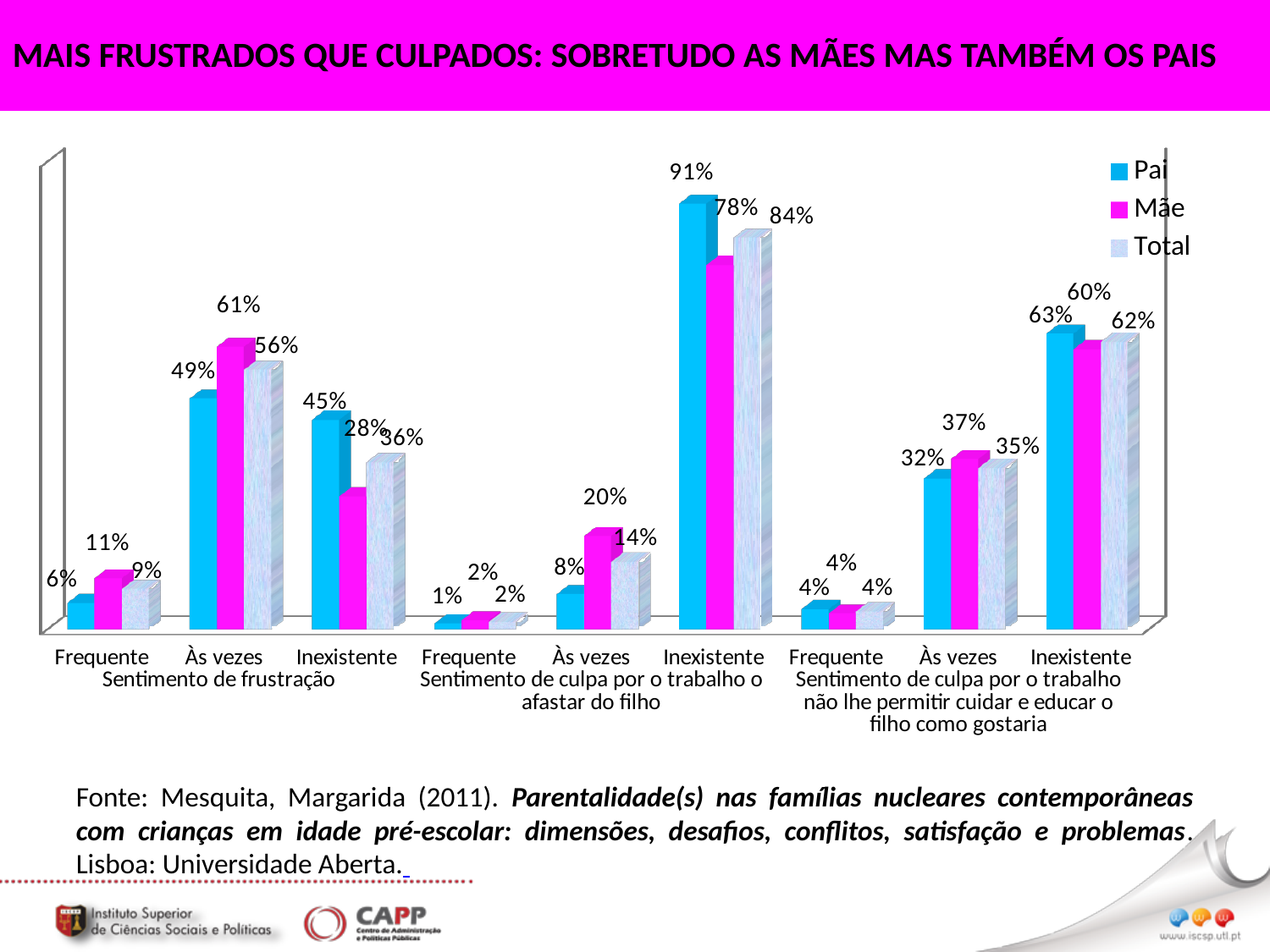
Which category has the lowest value for the Pai series? Frequente (Sentimento de culpa por o trabalho o afastar do filho) What is the difference between the Mãe and Total values for 'Inexistente' under 'Sentimento de culpa por o trabalho o afastar do filho'? 6% What is the value for Pai for 'Inexistente' under 'Sentimento de culpa por o trabalho o afastar do filho'? 91% What is the difference between the Pai and Mãe values for 'Inexistente' under 'Sentimento de frustração'? 17% What is the value for Mãe for 'Às vezes' under 'Sentimento de frustração'? 61% How many series does the legend list? 3 For 'Às vezes' under 'Sentimento de culpa por o trabalho o afastar do filho', which is larger, the Pai value or the Mãe value? Mãe Which category has the highest value for the Pai series? Inexistente (Sentimento de culpa por o trabalho o afastar do filho) What kind of chart is shown on the slide? bar chart What is the Total value for 'Às vezes' under 'Sentimento de culpa por o trabalho não lhe permitir cuidar e educar o filho como gostaria'? 35% Which series are listed in the legend? Pai, Mãe, Total How many category bars (groups) are plotted along the x axis? 9